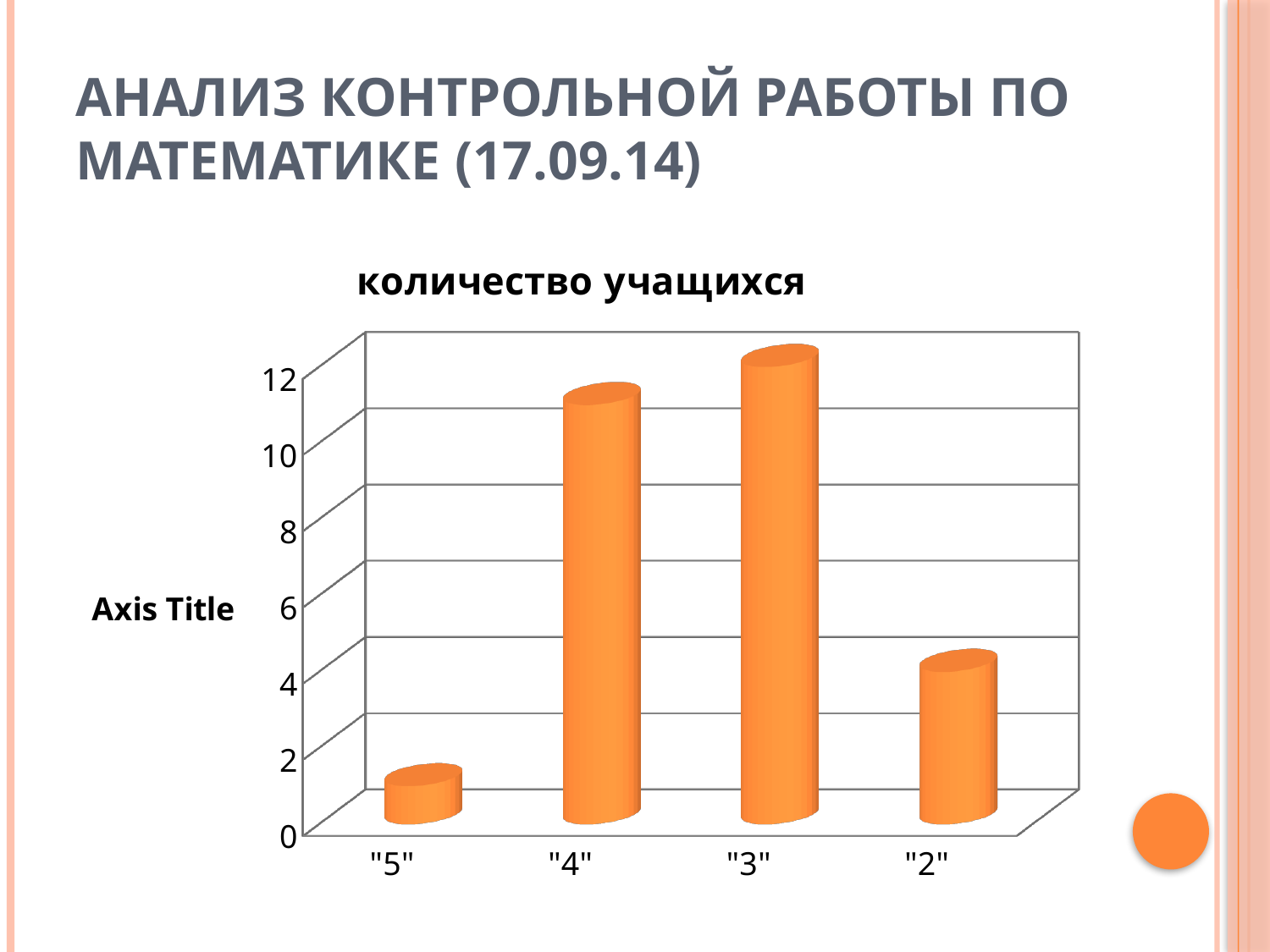
Which is larger, the value for "4" or the value for "2"? "4" How many categories are shown on the x axis of the chart? 4 Is the value for "4" greater or less than 10? greater What is the title of the chart? количество учащихся Is the value for "3" greater or less than 10? greater Which category has the lowest bar in the chart? "5" Which category has the highest bar in the chart? "3" What label is shown on the vertical axis of the chart? Axis Title Is the value for "5" greater or less than 2? less What kind of chart is shown on the slide? bar chart Which is larger, the value for "5" or the value for "2"? "2"